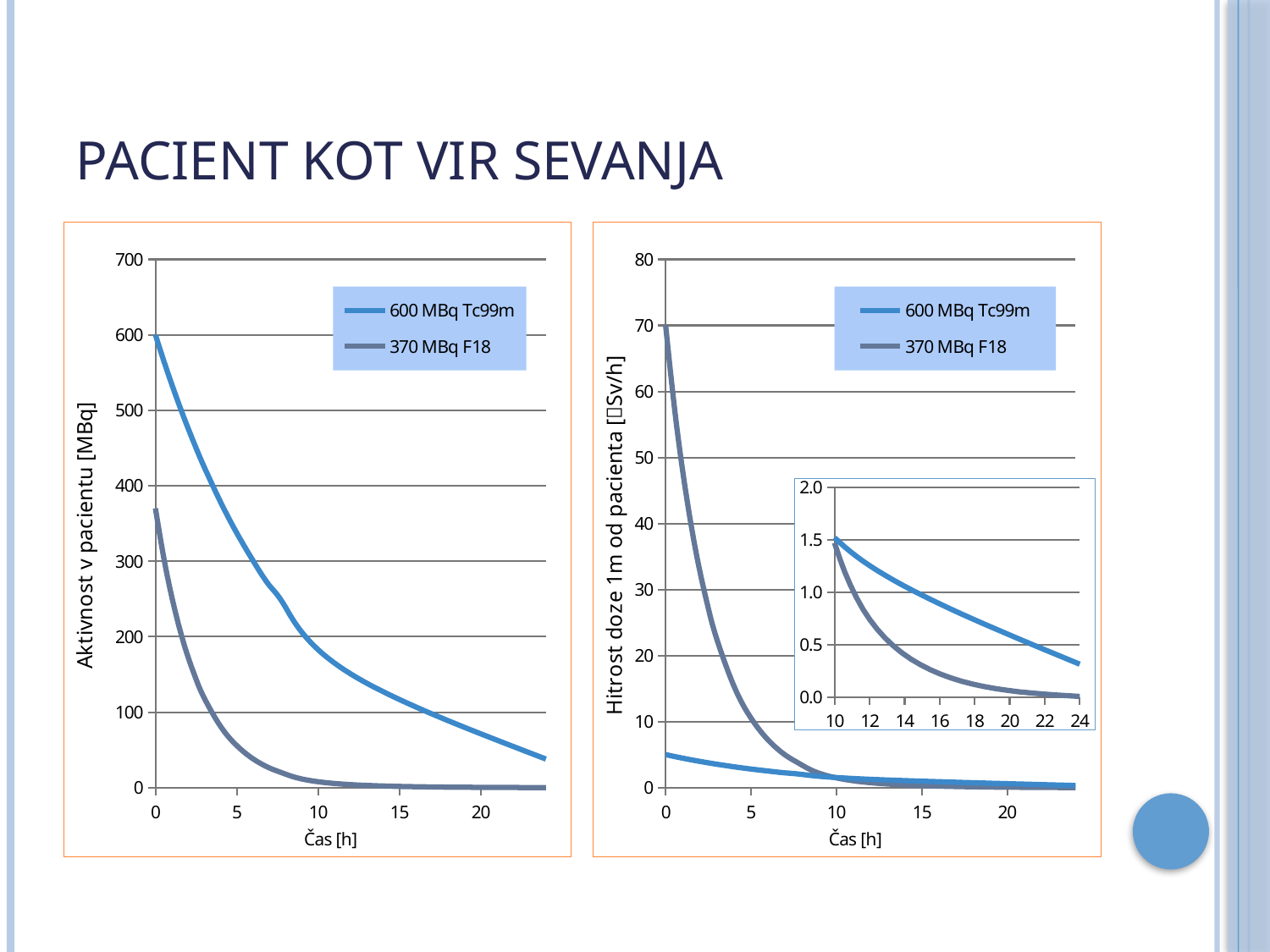
What is the x-axis label of the left chart? Čas [h] In the right chart, is the value for 600 MBq Tc99m at 0 h greater or less than 10? less In the left chart, is the value for 370 MBq F18 at 5 h greater or less than 100? less What are the two legend entries in the right chart (Hitrost doze 1m od pacienta)? 600 MBq Tc99m and 370 MBq F18 In the right chart, which series has the higher value at 0 h? 370 MBq F18 How many series does the legend of the left chart list? 2 In the left chart, is the value for 600 MBq Tc99m at 10 h greater or less than 300? less In the left chart, what is the activity of 600 MBq Tc99m at time 0 h? 600 In the left chart, which series has the higher value at 5 h? 600 MBq Tc99m In the right chart, what is the dose rate for 370 MBq F18 at time 0 h? 70 In the left chart, do the values rise or fall as time increases? fall What kind of chart is the left chart (Aktivnost v pacientu)? line chart